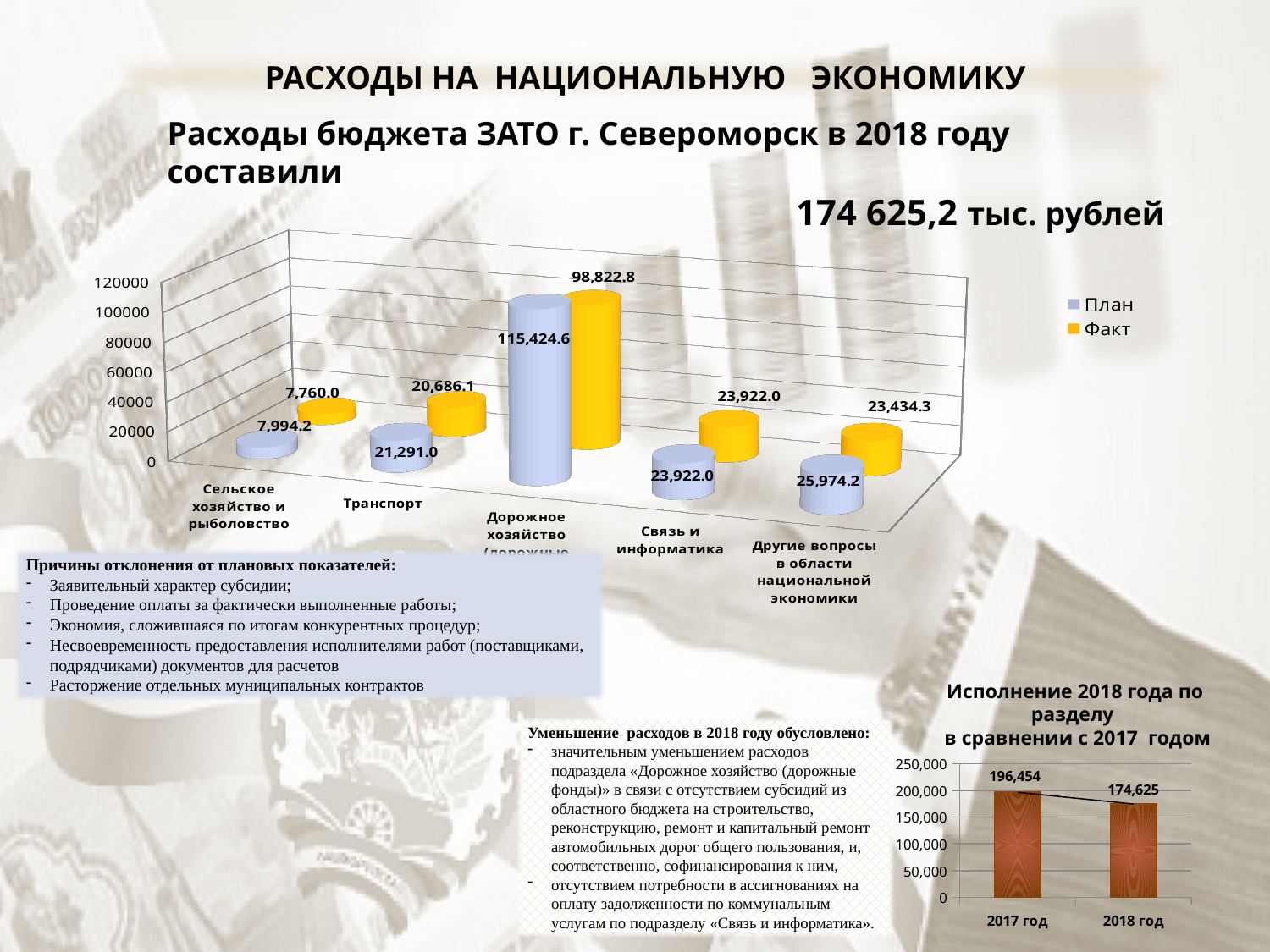
In the large План/Факт chart in the middle of the slide, which category has the lowest Факт value? Сельское хозяйство и рыболовство In the large План/Факт chart in the middle of the slide, what is the План value for Транспорт? 21,291.0 In the large План/Факт chart in the middle of the slide, what is the Факт value for Дорожное хозяйство? 98,822.8 In the chart titled 'Исполнение 2018 года по разделу в сравнении с 2017 годом', what is the value for 2017 год? 196,454 What kind of chart is the chart titled 'Исполнение 2018 года по разделу в сравнении с 2017 годом'? Bar chart How many categories are shown in the large План/Факт chart in the middle of the slide? 5 In the large План/Факт chart in the middle of the slide, what is the difference between the План and Факт values for Дорожное хозяйство? 16,601.8 How many series does the legend of the large План/Факт chart in the middle of the slide list? 2 In the chart titled 'Исполнение 2018 года по разделу в сравнении с 2017 годом', what is the difference between the 2017 год and 2018 год values? 21,829 In the large План/Факт chart in the middle of the slide, which category has the highest План value? Дорожное хозяйство In the large План/Факт chart in the middle of the slide, what is the Факт value for Сельское хозяйство и рыболовство? 7,760.0 In the large План/Факт chart in the middle of the slide, which is larger for Другие вопросы в области национальной экономики: План or Факт? План